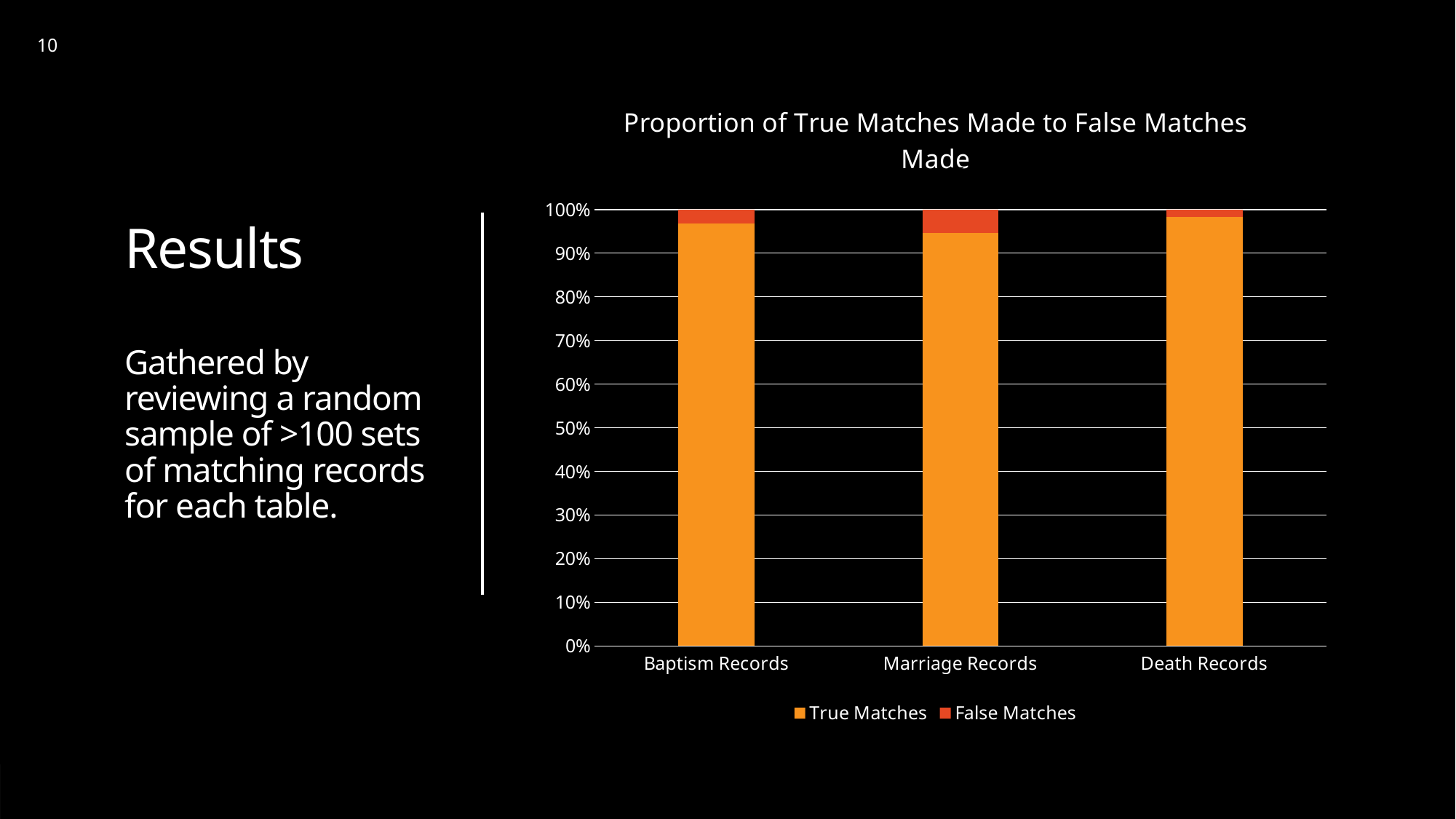
Is the True Matches share for Marriage Records greater or less than 90%? greater Which category has the largest share of True Matches? Death Records What kind of chart is shown on the slide? Stacked bar chart Which is larger: the False Matches share for Marriage Records or for Baptism Records? Marriage Records How many categories are shown on the x axis of the chart? 3 What is the total of the stacked bar for Baptism Records? 100% Is the False Matches share for Baptism Records greater or less than 10%? less How many series does the chart's legend list? 2 What is the title of the chart? Proportion of True Matches Made to False Matches Made Which series is shown in red in the chart? False Matches Which category has the largest share of False Matches? Marriage Records Which category has the smallest share of False Matches? Death Records